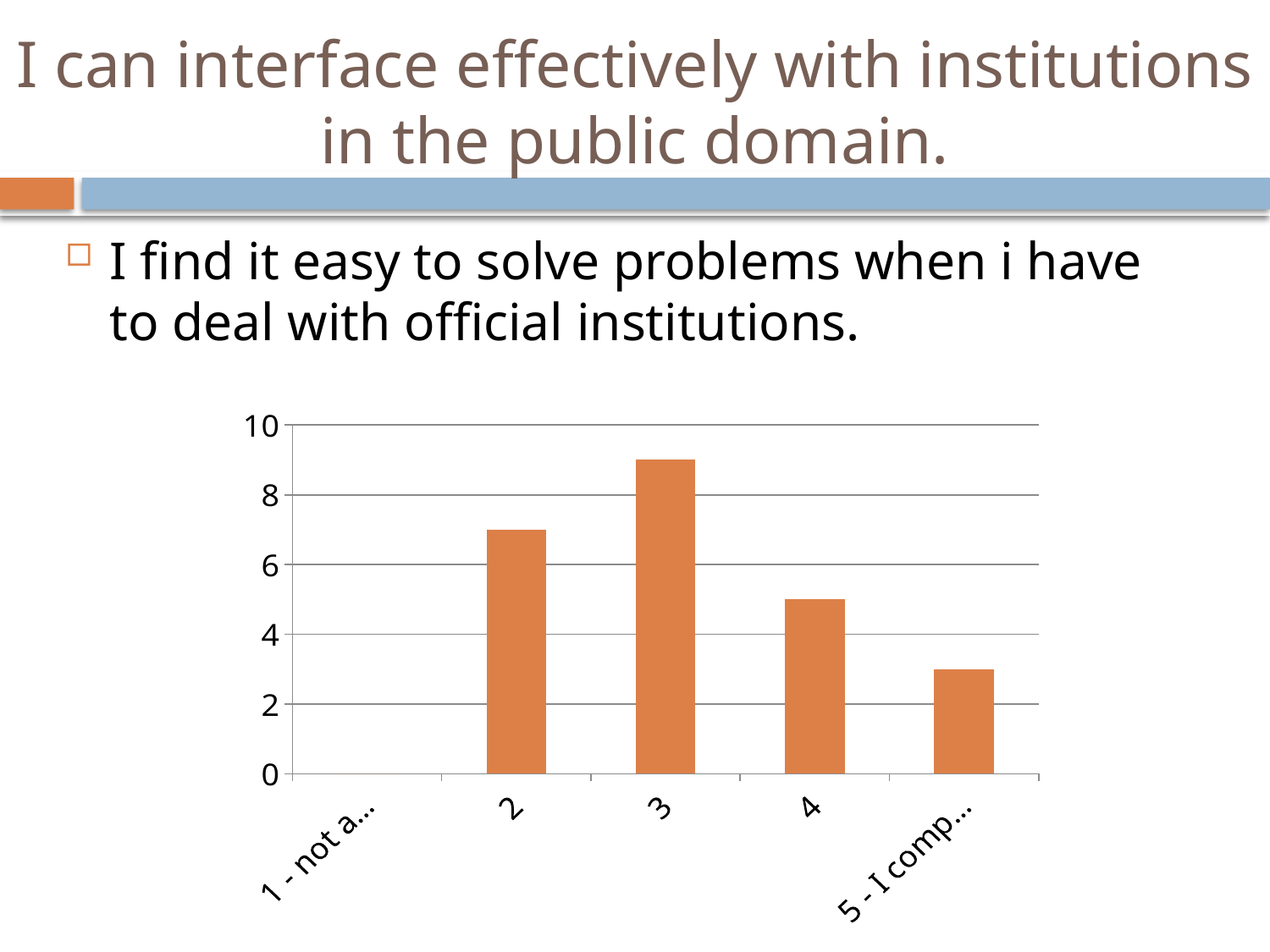
Is the value for category 4 greater or less than 4? greater What kind of chart is shown on the slide? bar chart Which has the larger value, category 2 or category 4? 2 What colour are the bars in the chart? orange Which category has the tallest bar in the chart? 3 Is the value for category 2 greater or less than 8? less Is the value for category 2 greater or less than 6? greater Do the bar values rise or fall from category 3 to the last category (5 - I comp...)? fall How many categories are shown on the x axis of the chart? 5